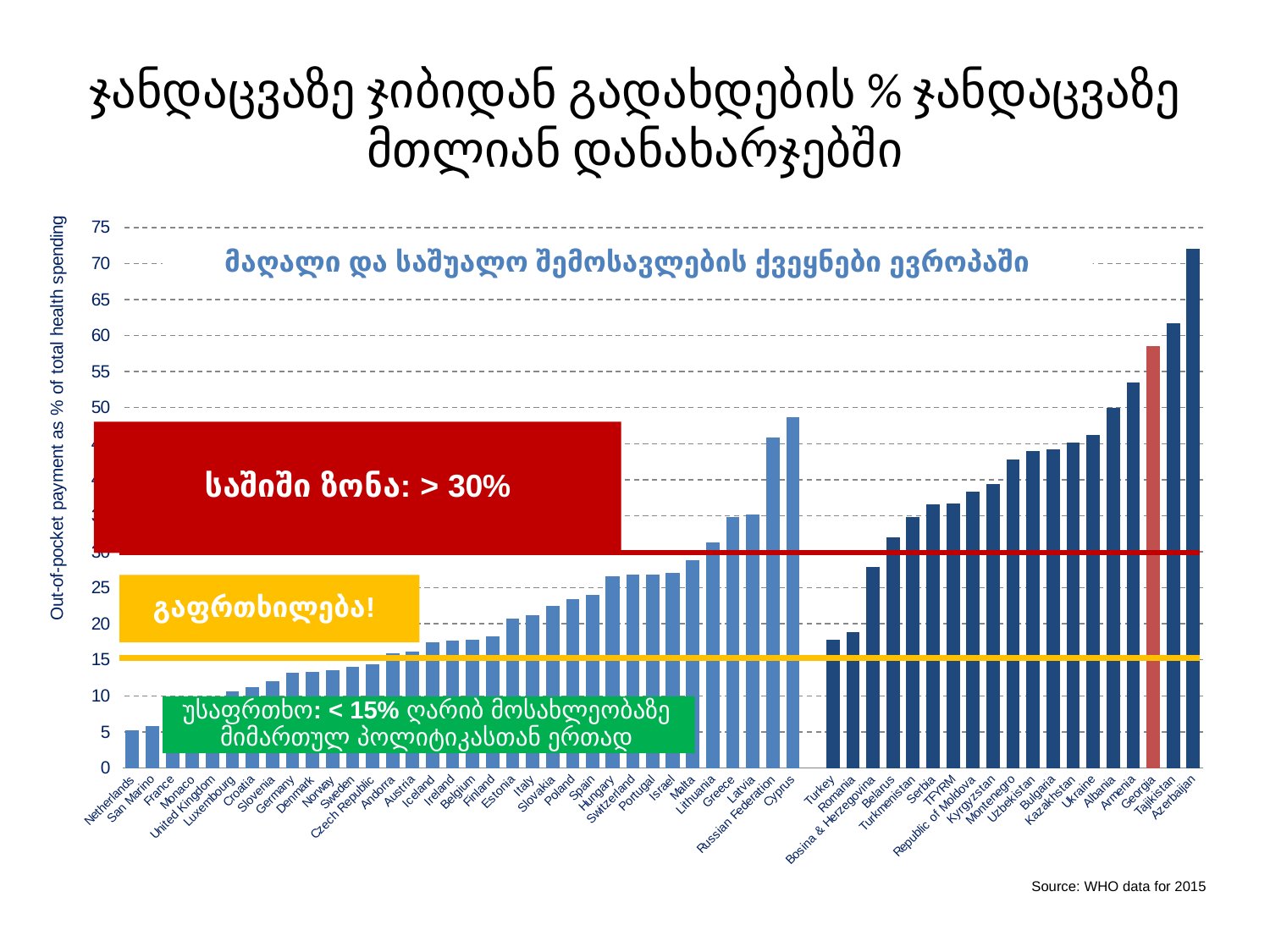
Which has a higher value, Turkey or Cyprus? Cyprus Which country has the highest out-of-pocket payment share on the chart? Azerbaijan What is the label of the vertical axis? Out-of-pocket payment as % of total health spending What kind of chart is shown on the slide? bar chart Which country has the lowest out-of-pocket payment share on the chart? Netherlands Do the bars rise or fall from Netherlands to Cyprus along the x axis? rise Is the value for Cyprus greater or less than 40? greater Which has a higher value, Azerbaijan or Tajikistan? Azerbaijan Is the value for Netherlands greater or less than 10? less What source is cited for the chart data? WHO data for 2015 Is the value for Georgia greater or less than 50? greater